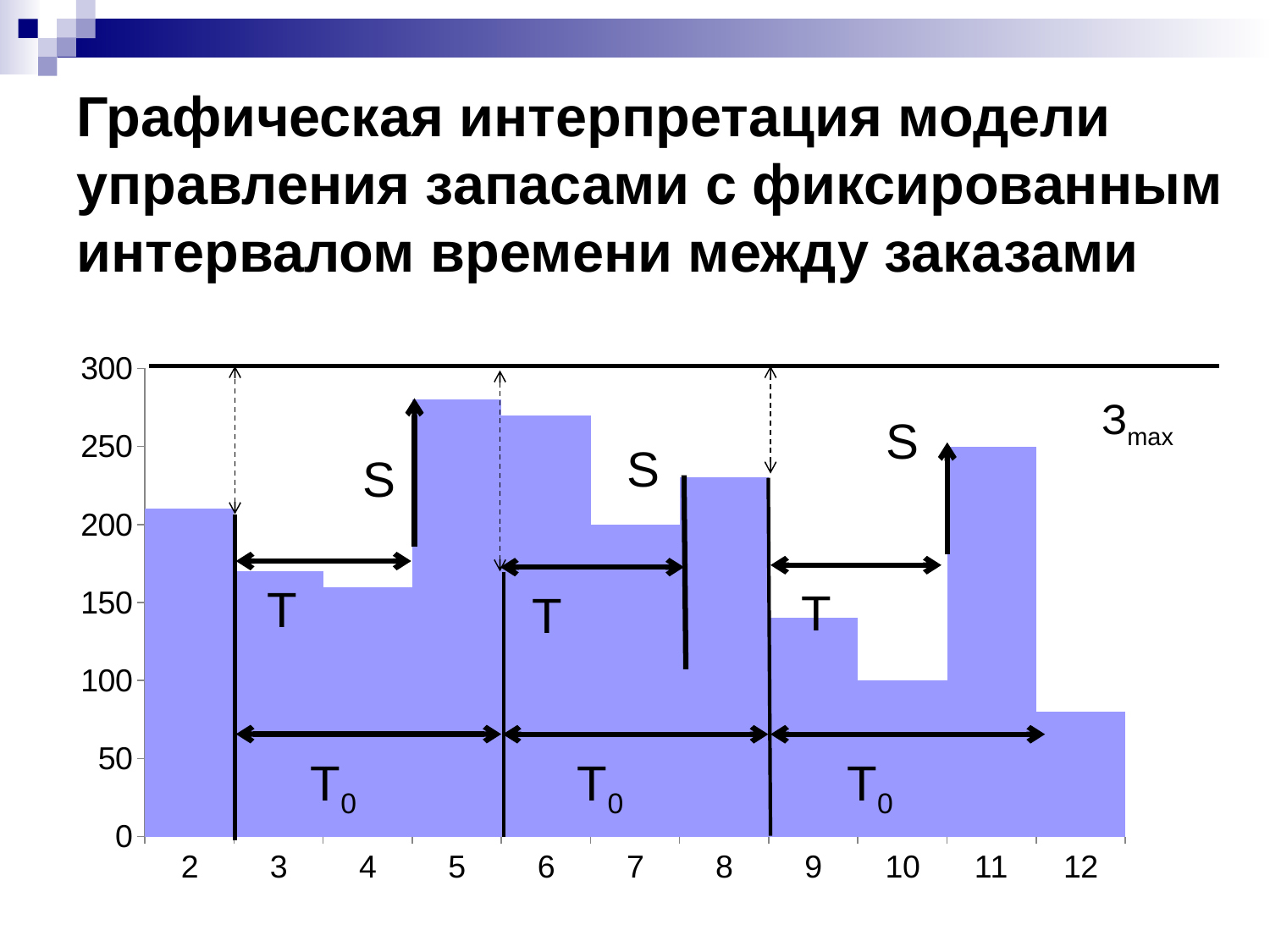
Is the value for category 5 greater or less than 250? greater What kind of chart is shown on the slide? bar chart What is the value for category 11? 250 What is the value for category 10? 100 Is the value for category 9 greater or less than 150? less What is the value for category 7? 200 Is the value for category 12 greater or less than 100? less Which category has the lowest value in the chart? 12 How many categories are shown on the x axis of the chart? 11 Which is larger, the value for category 5 or the value for category 9? category 5 At what level on the y axis is the horizontal line labelled Зmax drawn? 300 Do the values rise or fall from category 2 to category 4? fall